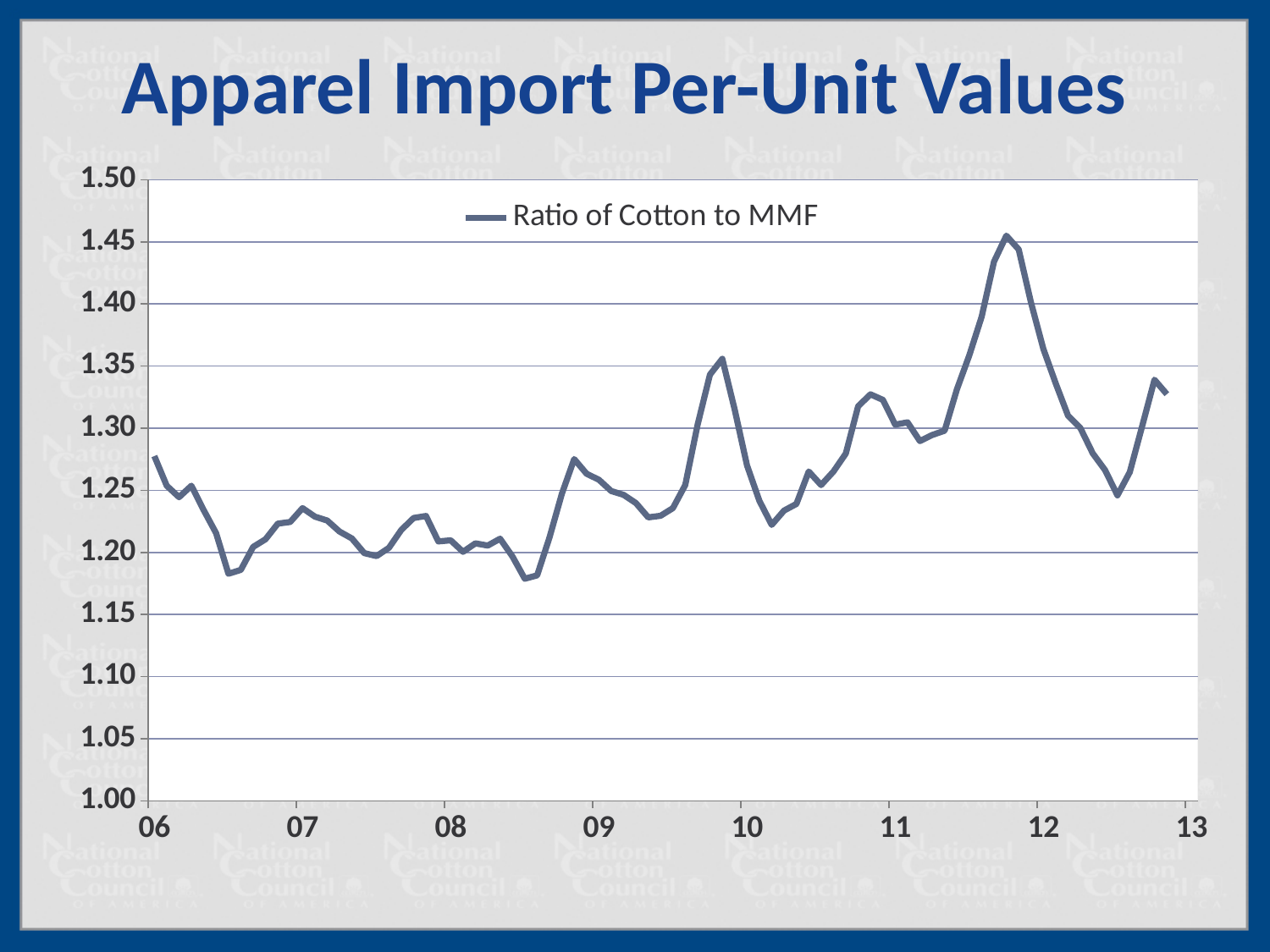
Is the lowest value reached by the Ratio of Cotton to MMF greater or less than 1.20? less Is the highest value reached by the Ratio of Cotton to MMF greater or less than 1.40? greater What is the title of the chart? Apparel Import Per-Unit Values Is the value of the Ratio of Cotton to MMF at the 07 tick greater or less than 1.25? less How many series does the legend list? 1 Does the Ratio of Cotton to MMF rise or fall between the 11 tick and its peak just before the 12 tick? rise How many year labels are shown on the x axis? 8 Does the Ratio of Cotton to MMF rise or fall between the 06 tick and the 07 tick? fall What series name appears in the legend? Ratio of Cotton to MMF What kind of chart is shown on the slide? line chart